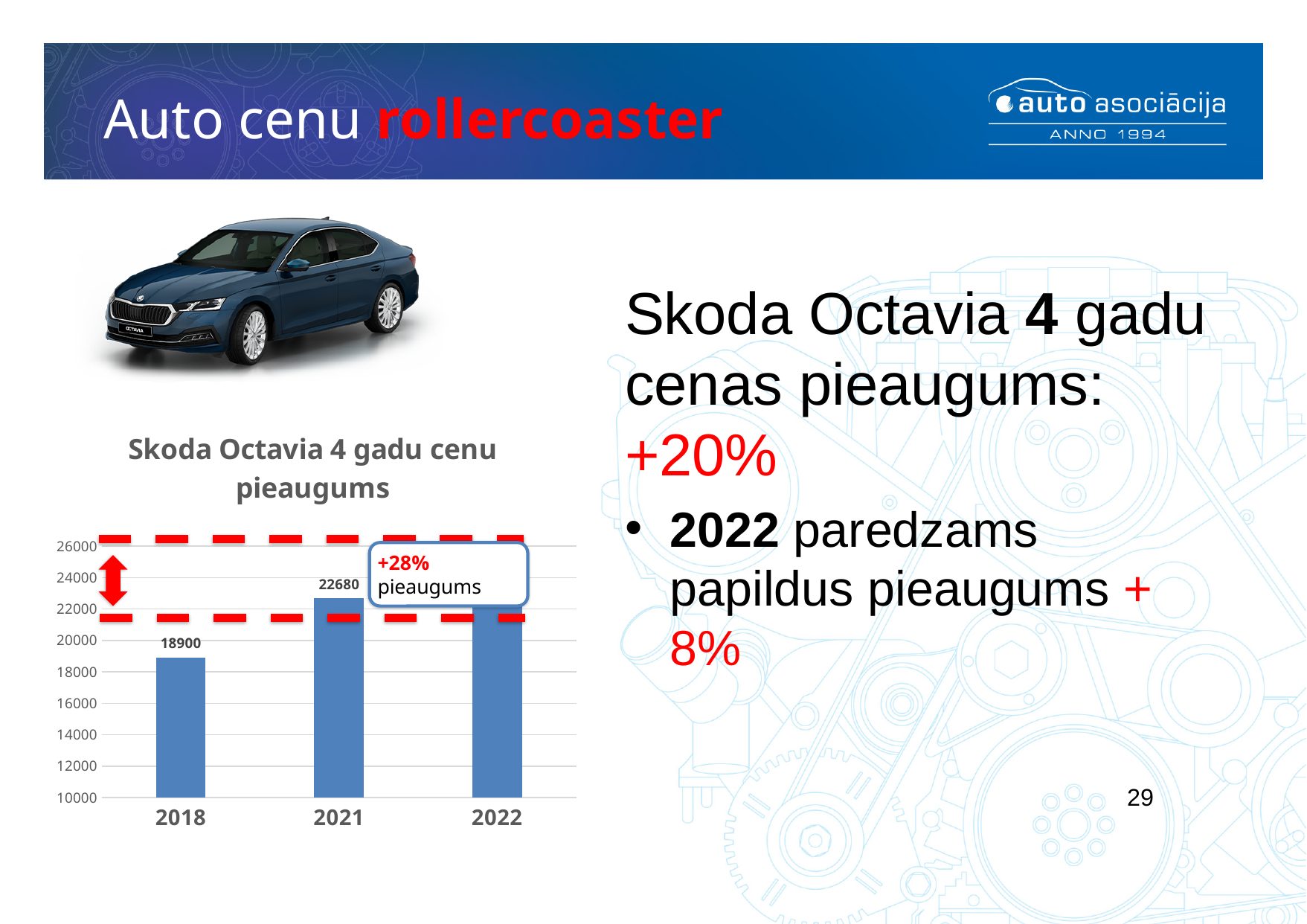
Is the value for 2022 greater or less than 26000? less What is the title of the chart? Skoda Octavia 4 gadu cenu pieaugums Which is larger, the value for 2021 or the value for 2018? 2021 How many years are shown on the x axis? 3 Which year has the lowest value? 2018 Which year has the highest value? 2022 What is the value for 2018? 18900 Do the values rise or fall from 2018 to 2022? rise What is the value for 2021? 22680 Is the value for 2022 greater or less than 22000? greater What kind of chart is shown on the slide? bar chart What is the difference between the values for 2021 and 2018? 3780